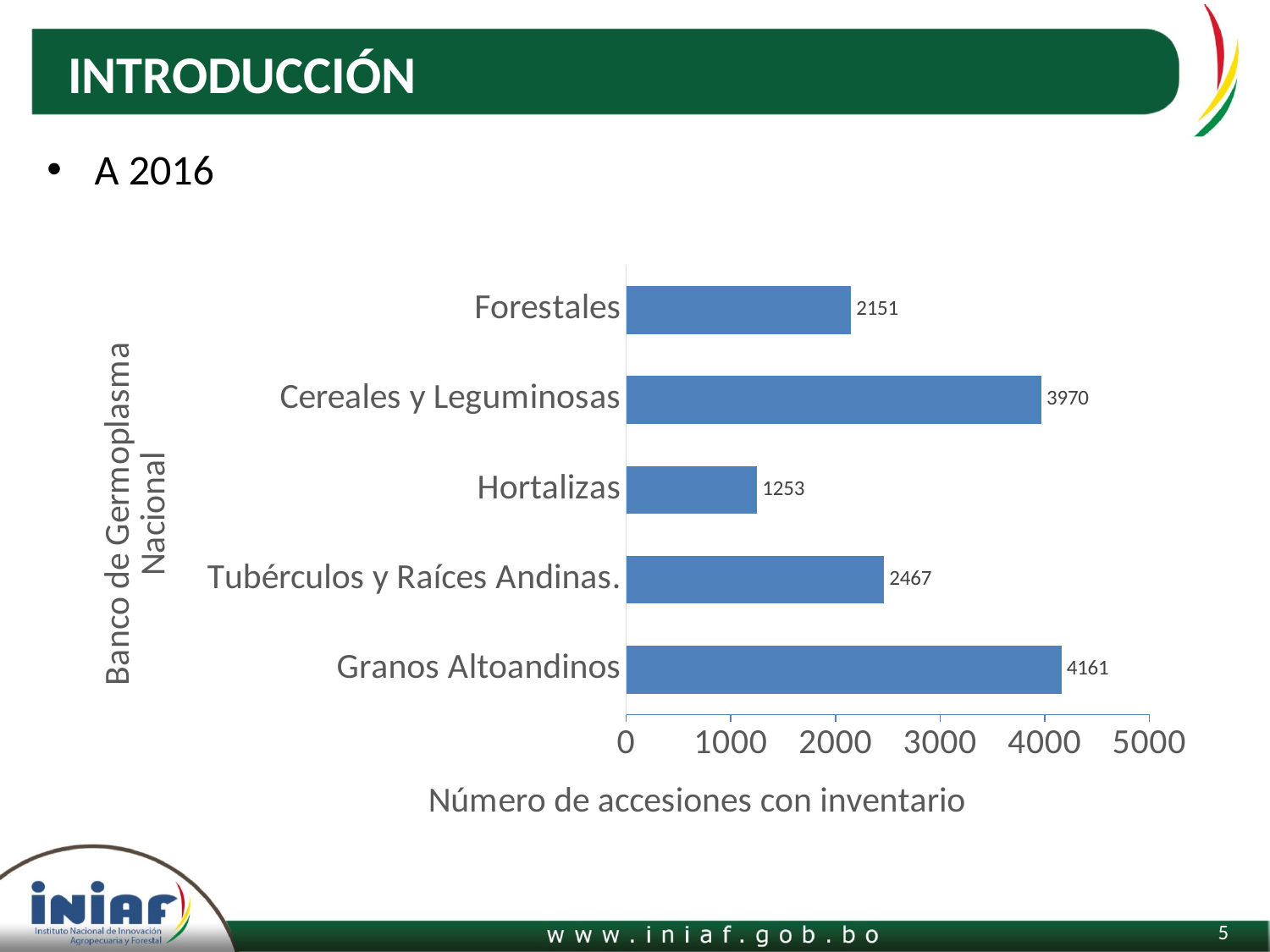
What is the value for Granos Altoandinos? 4161 Which category has the highest number of accesiones con inventario? Granos Altoandinos What is the difference between the values for Granos Altoandinos and Cereales y Leguminosas? 191 What is the value for Hortalizas? 1253 Which category has the lowest number of accesiones con inventario? Hortalizas What is the label of the horizontal axis? Número de accesiones con inventario What is the value for Cereales y Leguminosas? 3970 What kind of chart is shown on the slide? Bar chart How many categories are shown in the chart? 5 What is the difference between the values for Tubérculos y Raíces Andinas and Hortalizas? 1214 Which is larger, the value for Forestales or the value for Tubérculos y Raíces Andinas? Tubérculos y Raíces Andinas What is the value for Forestales? 2151